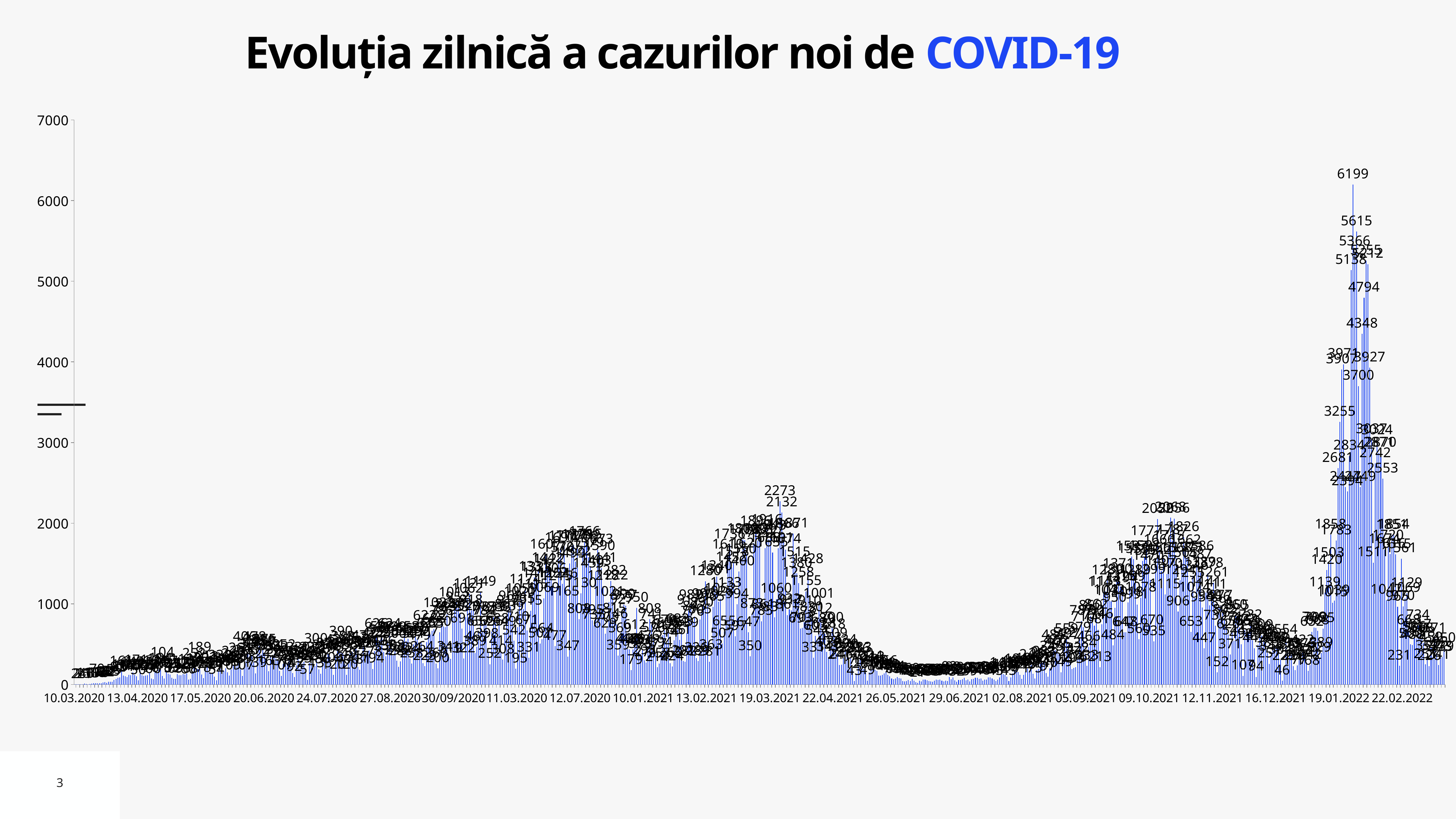
What is the second-highest value labelled near the peak in early 2022? 5615 What kind of chart is shown on the slide? bar chart What is the difference between the two highest labelled values, 6199 and 5615? 584 Do the values rise or fall between 22.04.2021 and 26.05.2021? fall Is the peak value around 09.10.2021 greater or less than 3000? less Is the highest bar on the chart greater or less than 6000? greater What is the highest daily value labelled on the chart? 6199 What is the highest tick value shown on the vertical axis? 7000 What is the title of the chart? Evoluția zilnică a cazurilor noi de COVID-19 Do the values rise or fall between 05.09.2021 and 09.10.2021? rise Which peak is higher: the one around 19.03.2021 or the one in early 2022? early 2022 Is the peak value around 19.03.2021 greater or less than 3000? less